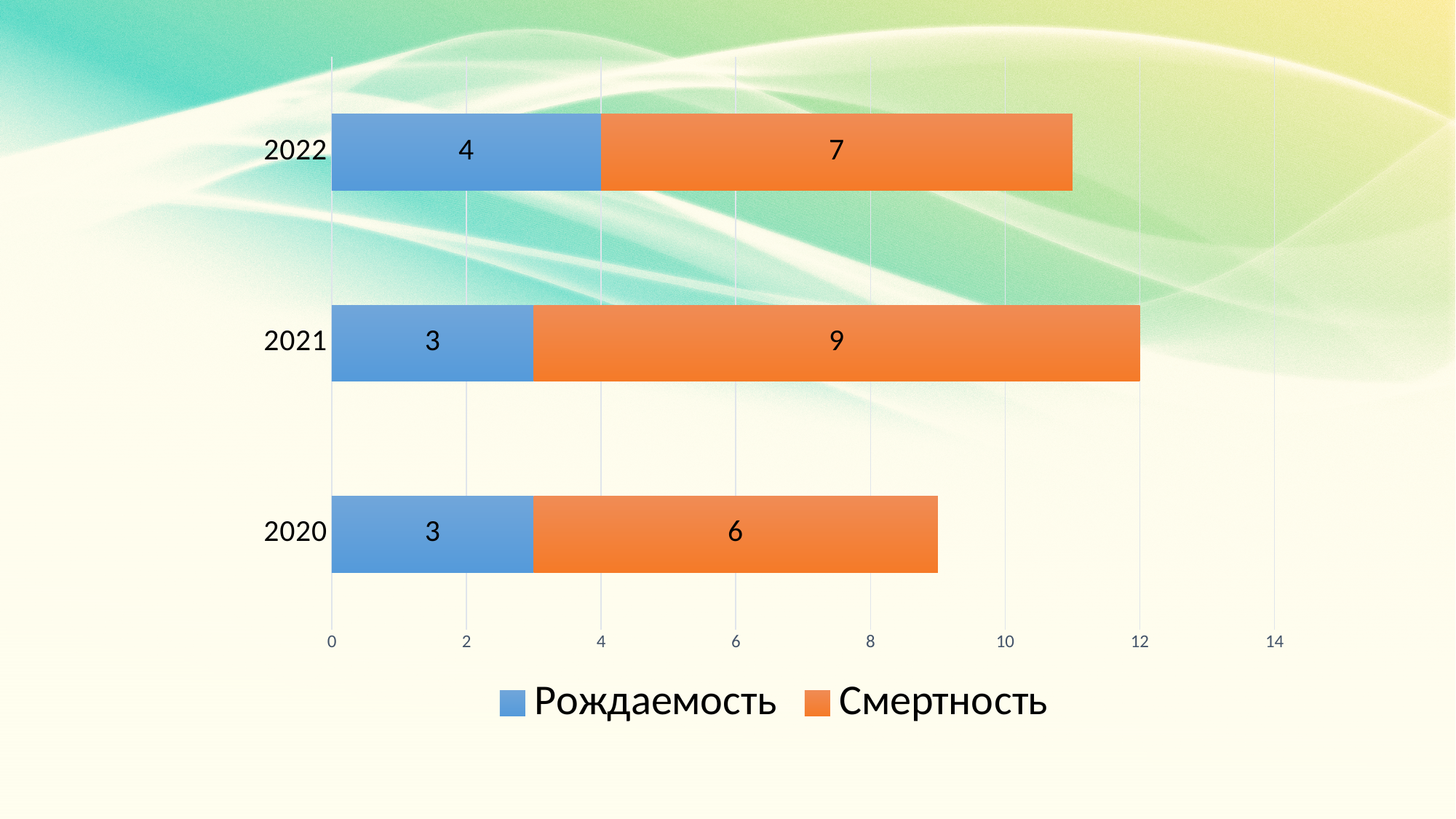
What is the value of Смертность for 2020? 6 What is the total of the stacked bar for 2021? 12 What kind of chart is shown on the slide? Stacked bar chart How many series does the legend list? 2 What is the value of Рождаемость for 2022? 4 Which year has the lowest Смертность value? 2020 Which is larger in 2022, Рождаемость or Смертность? Смертность What is the total of the stacked bar for 2020? 9 Which year has the highest Смертность value? 2021 What is the value of Смертность for 2021? 9 What is the difference between Смертность and Рождаемость in 2021? 6 How many years are shown on the chart? 3